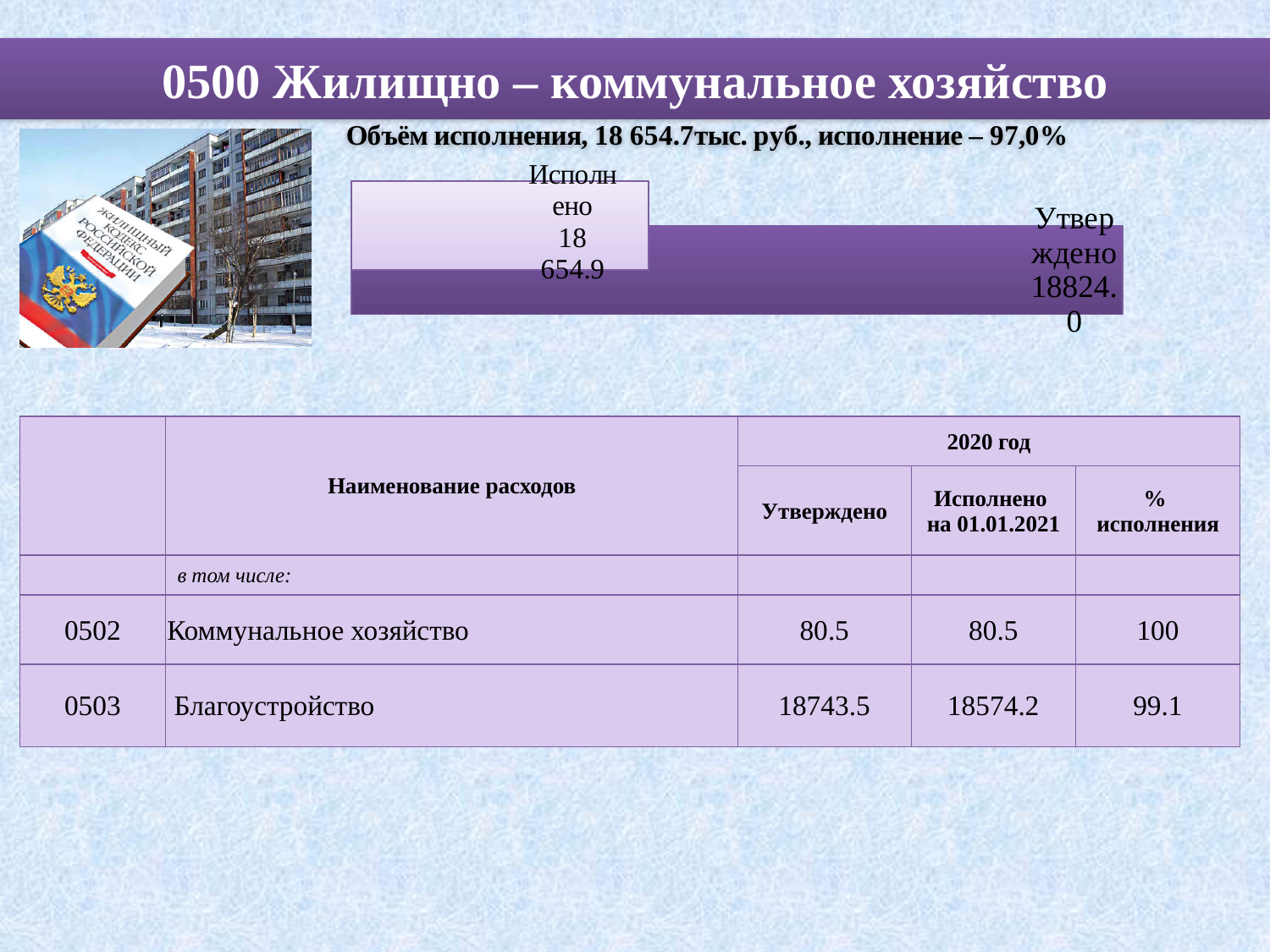
Is the value for Утверждено larger or smaller than the value for Исполнено? larger What value is shown for the Исполнено bar in the chart? 18 654.9 Which bar in the chart has the higher value? Утверждено Which bar in the chart has the lower value? Исполнено What is the difference between the Утверждено value and the Исполнено value in the chart? 169.1 What value is shown for the Утверждено bar in the chart? 18824.0 Which bar in the chart is drawn in the darker purple colour? Утверждено How many bars are plotted in the chart? 2 What kind of chart is shown on the slide? bar chart Are the bars in the chart oriented horizontally or vertically? horizontally